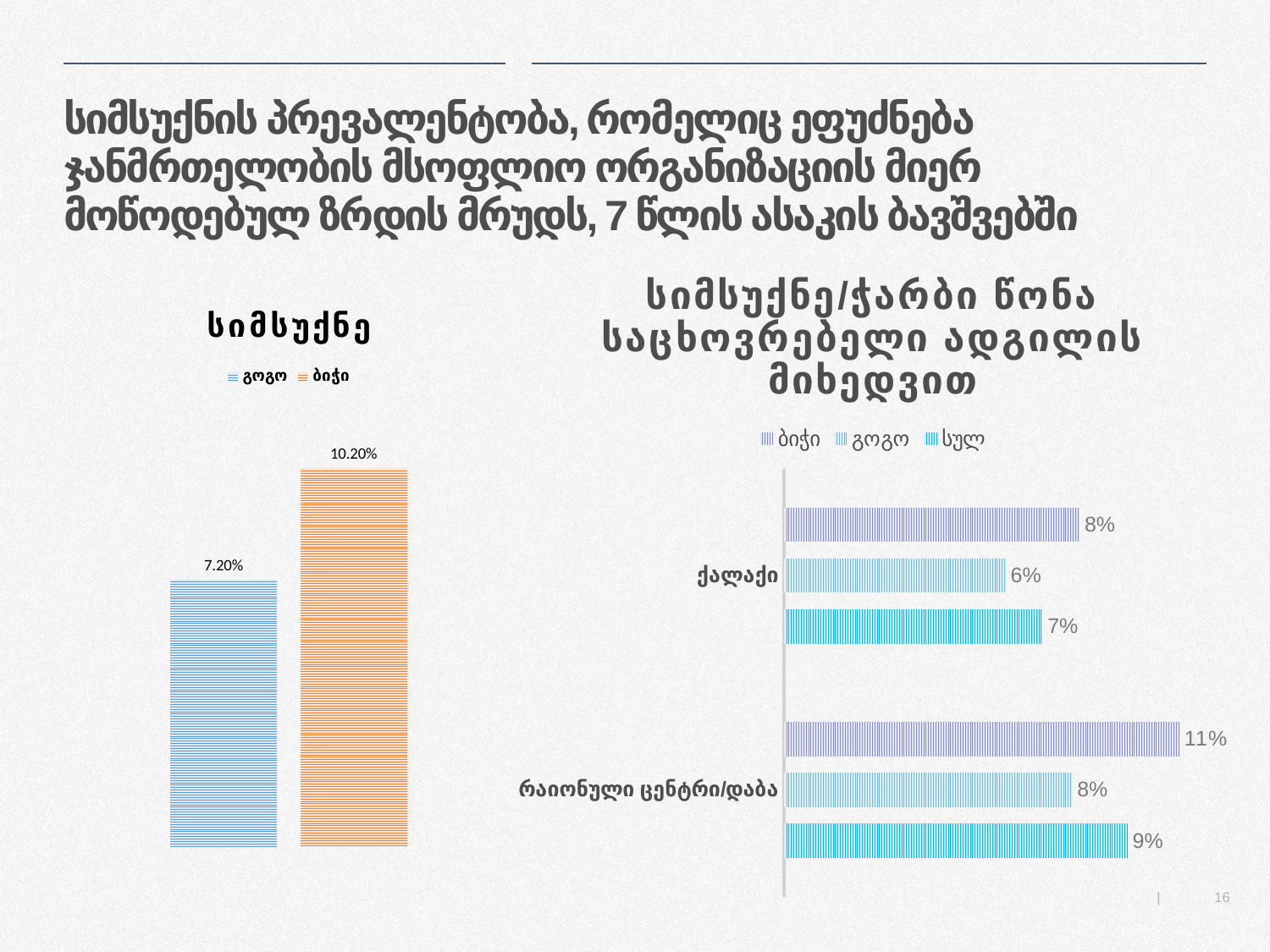
How many categories are shown in the right chart? 2 In the right chart, which category has the highest value for ბიჭი? რაიონული ცენტრი/დაბა How many series does the legend of the right chart list? 3 In the right chart, what is the value for სულ in the რაიონული ცენტრი/დაბა category? 9% In the right chart, what is the value for ბიჭი in the რაიონული ცენტრი/დაბა category? 11% In the left chart titled "სიმსუქნე", what is the value for ბიჭი? 10.20% In the right chart, what is the difference between the სულ values for რაიონული ცენტრი/დაბა and ქალაქი? 2% In the left chart titled "სიმსუქნე", what is the value for გოგო? 7.20% In the right chart, what is the value for გოგო in the ქალაქი category? 6% In the left chart titled "სიმსუქნე", what is the difference between the values for ბიჭი and გოგო? 3.00% What kind of chart is the left chart titled "სიმსუქნე"? Bar chart In the left chart titled "სიმსუქნე", which is larger, ბიჭი or გოგო? ბიჭი